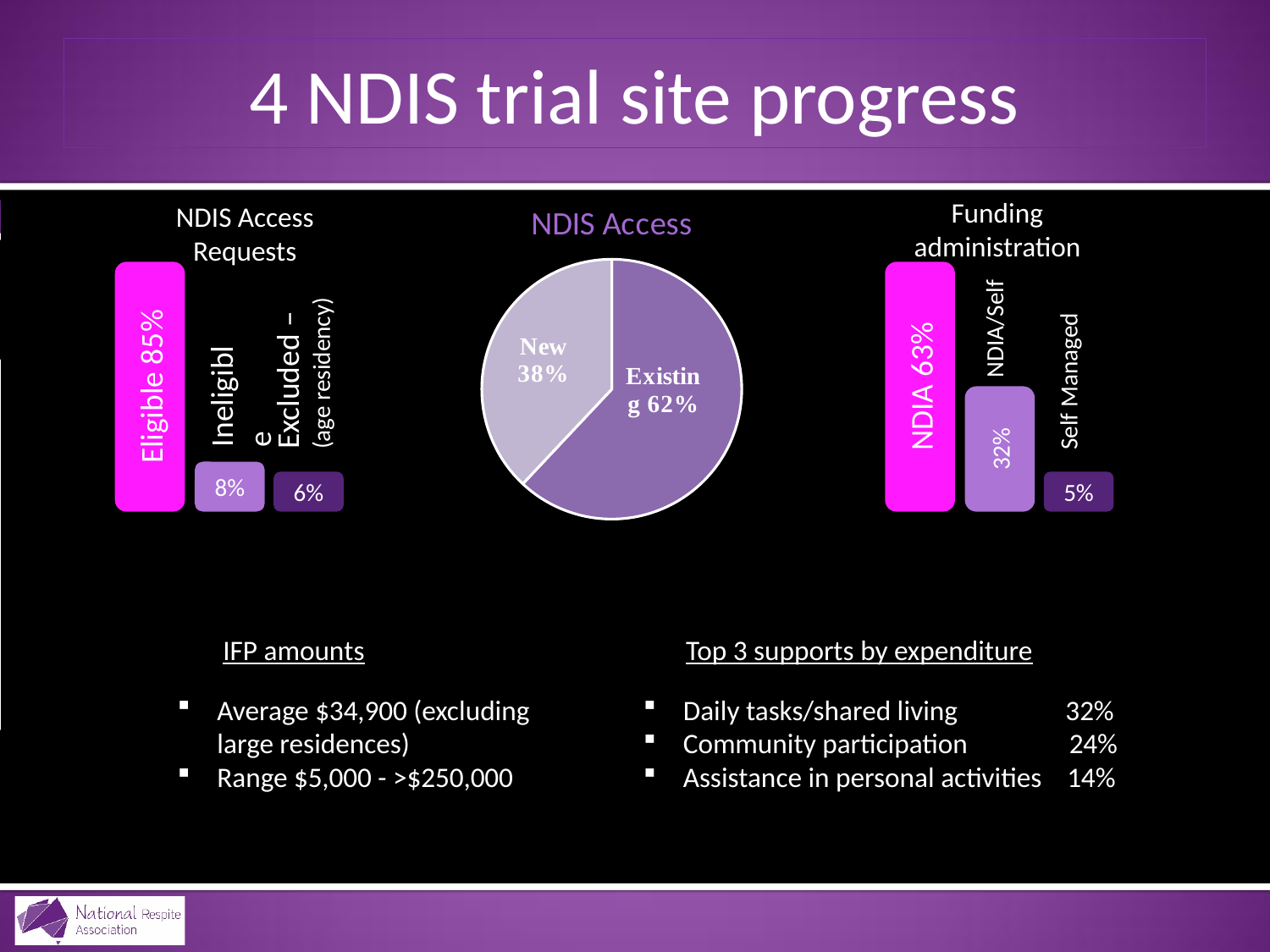
In the Funding administration chart, what is the difference between NDIA and Self Managed? 58% In the NDIS Access Requests chart, what is the difference between Eligible and Ineligible? 77% In the NDIS Access pie chart, what share is labelled Existing? 62% In the NDIS Access pie chart, which slice is larger, New or Existing? Existing In the Funding administration chart, which category has the highest value? NDIA In the Funding administration chart, what is the value for NDIA/Self? 32% In the NDIS Access Requests chart, what is the value for Ineligible? 8% In the NDIS Access pie chart, what share is labelled New? 38% In the NDIS Access Requests chart, what is the value for Eligible? 85% How many slices does the NDIS Access pie chart have? 2 What kind of chart is the NDIS Access chart in the middle of the slide? Pie chart In the NDIS Access Requests chart, which category has the lowest value? Excluded (age residency)